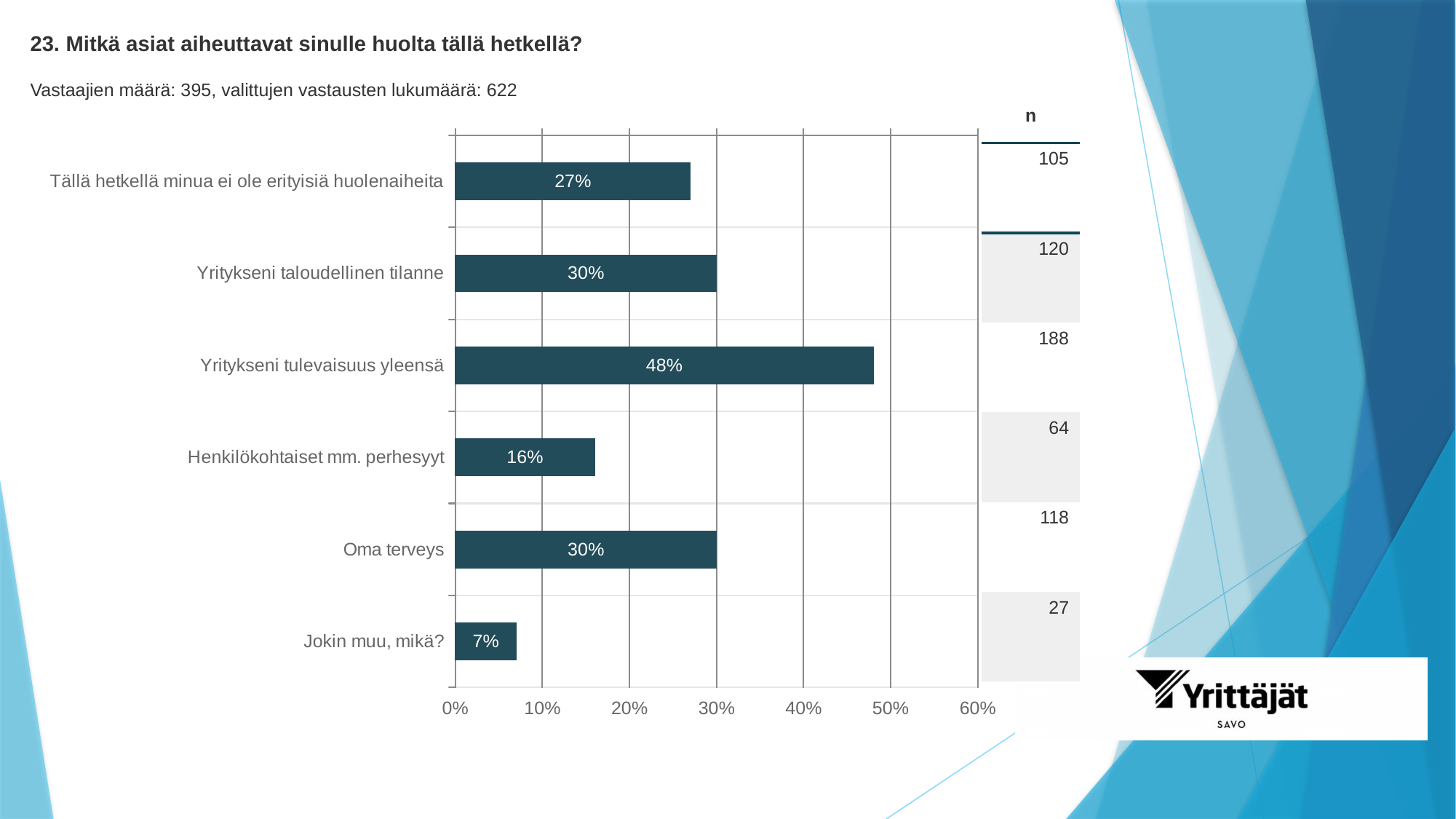
What is the n value shown for "Jokin muu, mikä?"? 27 What is the difference in percentage points between "Yritykseni tulevaisuus yleensä" and "Tällä hetkellä minua ei ole erityisiä huolenaiheita"? 21 percentage points How many categories are shown in the chart? 6 What is the maximum value shown on the x axis? 60% Is the value for "Yritykseni tulevaisuus yleensä" greater or less than 40%? greater What is the n value shown for "Oma terveys"? 118 Which category has the lowest percentage? Jokin muu, mikä? What kind of chart is shown on the slide? Bar chart Which category has the highest percentage? Yritykseni tulevaisuus yleensä What percentage is shown for "Yritykseni tulevaisuus yleensä"? 48% Which has a higher percentage, "Oma terveys" or "Henkilökohtaiset mm. perhesyyt"? Oma terveys What percentage is shown for "Henkilökohtaiset mm. perhesyyt"? 16%